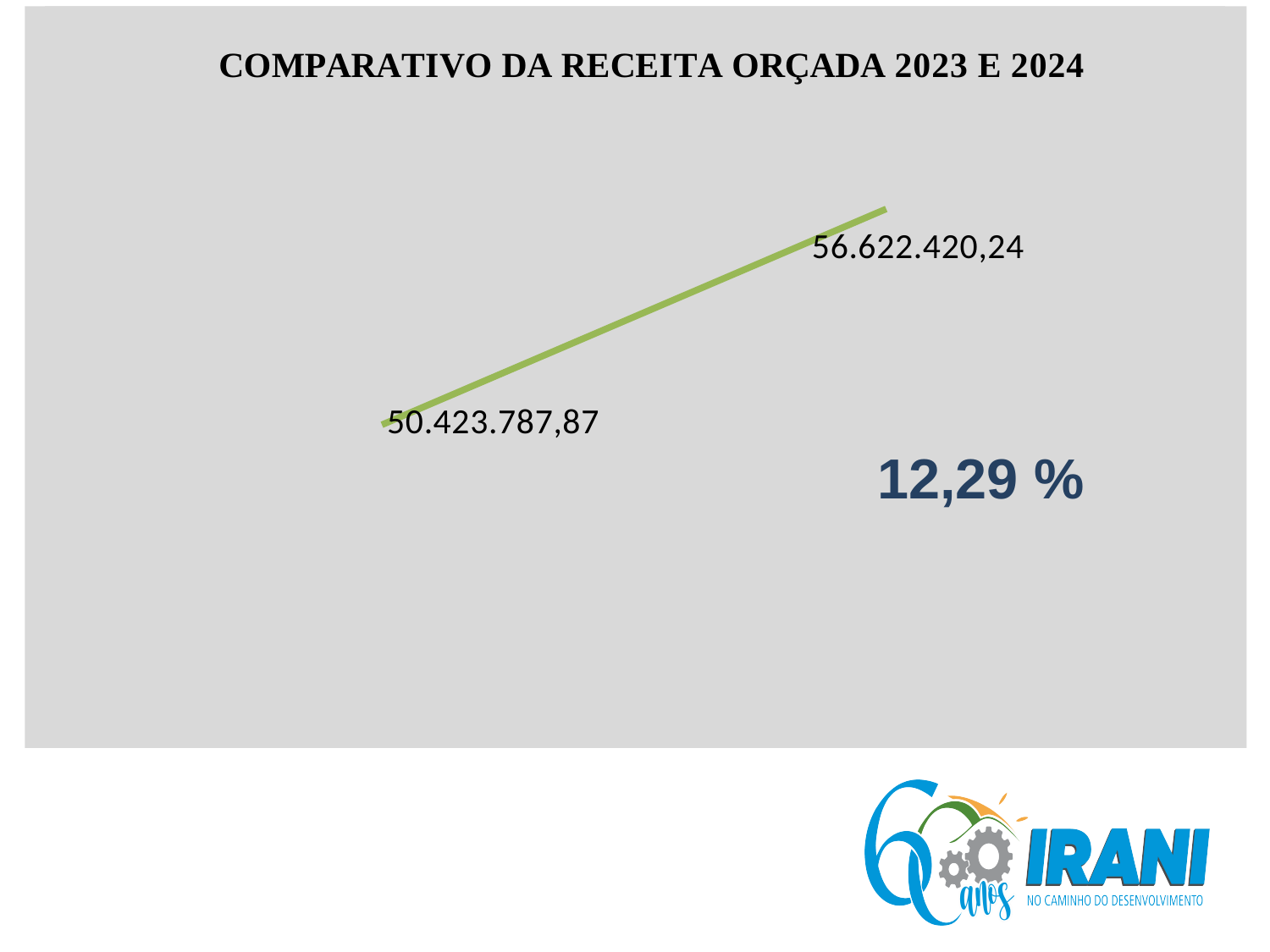
What is the lowest value plotted on the chart? 50.423.787,87 Which data point has the higher value, the left one or the right one? the right one (56.622.420,24) What is the value of the first (left) data point on the line? 50.423.787,87 What type of chart is shown on the slide? line chart How many data points are plotted on the line? 2 Does the line rise or fall from left to right? rises What is the highest value plotted on the chart? 56.622.420,24 What is the title of the chart? COMPARATIVO DA RECEITA ORÇADA 2023 E 2024 What is the value of the second (right) data point on the line? 56.622.420,24 What is the difference between the two plotted values? 6.198.632,37 What colour is the line in the chart? green What percentage is printed on the chart next to the line? 12,29 %